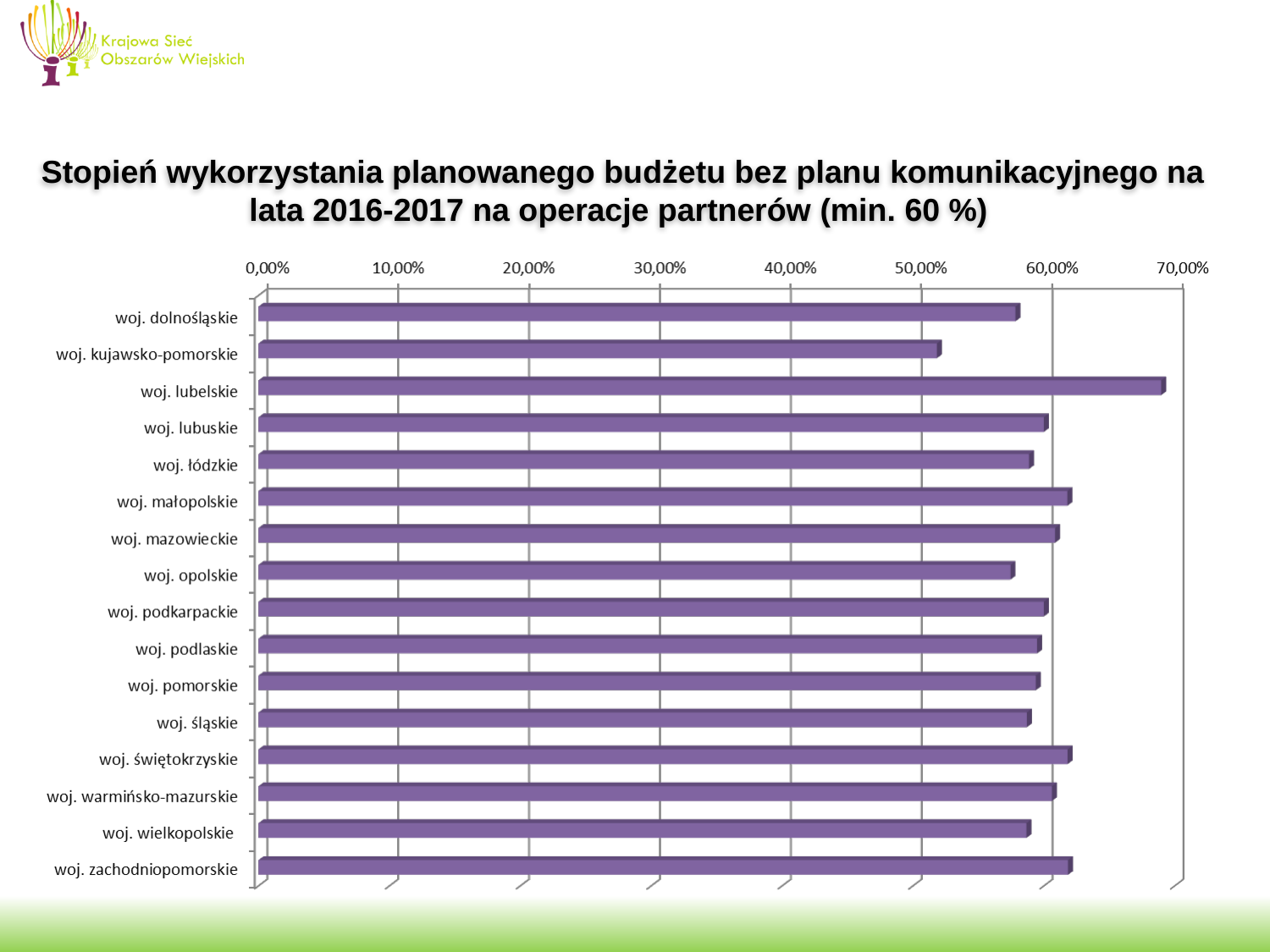
Is the value for woj. kujawsko-pomorskie greater or less than 50,00%? greater How many voivodeships (categories) are plotted in the chart? 16 Which is larger, the value for woj. lubelskie or the value for woj. małopolskie? woj. lubelskie Which voivodeship has the highest value in the chart? woj. lubelskie Is the value for woj. dolnośląskie greater or less than 60,00%? less Is the value for woj. kujawsko-pomorskie greater or less than 60,00%? less What kind of chart is shown on the slide? bar chart Which is larger, the value for woj. dolnośląskie or the value for woj. kujawsko-pomorskie? woj. dolnośląskie What is the highest value shown on the horizontal axis of the chart? 70,00% Which voivodeship has the lowest value in the chart? woj. kujawsko-pomorskie